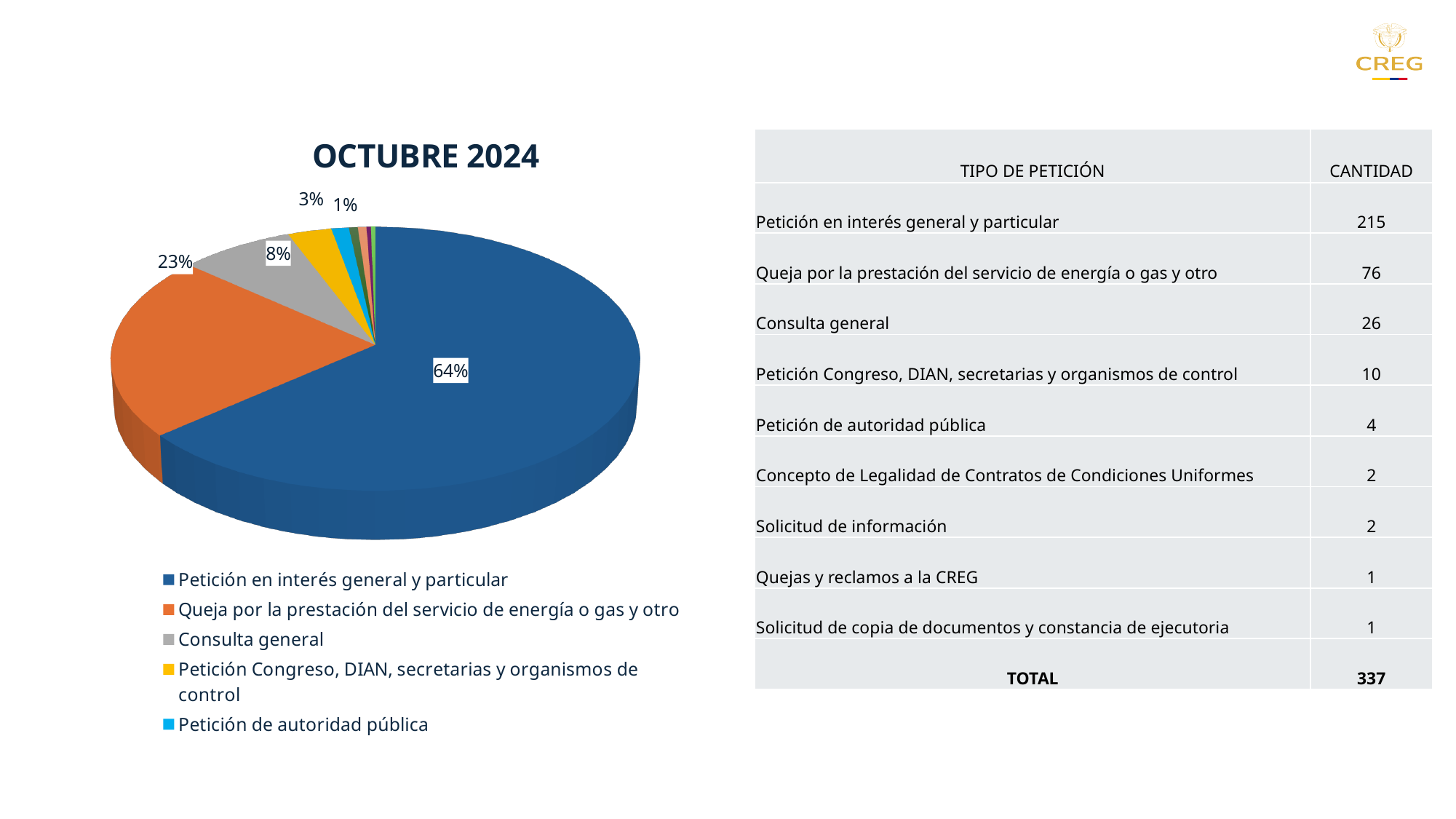
Which is larger: the slice for 'Queja por la prestación del servicio de energía o gas y otro' or the slice for 'Consulta general'? Queja por la prestación del servicio de energía o gas y otro Which category has the largest slice of the pie? Petición en interés general y particular What is the difference in percentage points between the 'Petición en interés general y particular' slice and the 'Queja por la prestación del servicio de energía o gas y otro' slice? 41 percentage points What share of the pie does 'Petición en interés general y particular' represent? 64% What percentage is shown for 'Consulta general'? 8% What percentage is shown for 'Queja por la prestación del servicio de energía o gas y otro'? 23% What is the difference in percentage points between the 'Queja por la prestación del servicio de energía o gas y otro' slice and the 'Consulta general' slice? 15 percentage points What is the title of the pie chart? OCTUBRE 2024 What kind of chart is shown on the slide? pie chart How many entries does the legend of the pie chart list? 5 What colour is the largest slice of the pie chart? blue What percentage is shown for 'Petición Congreso, DIAN, secretarias y organismos de control'? 3%